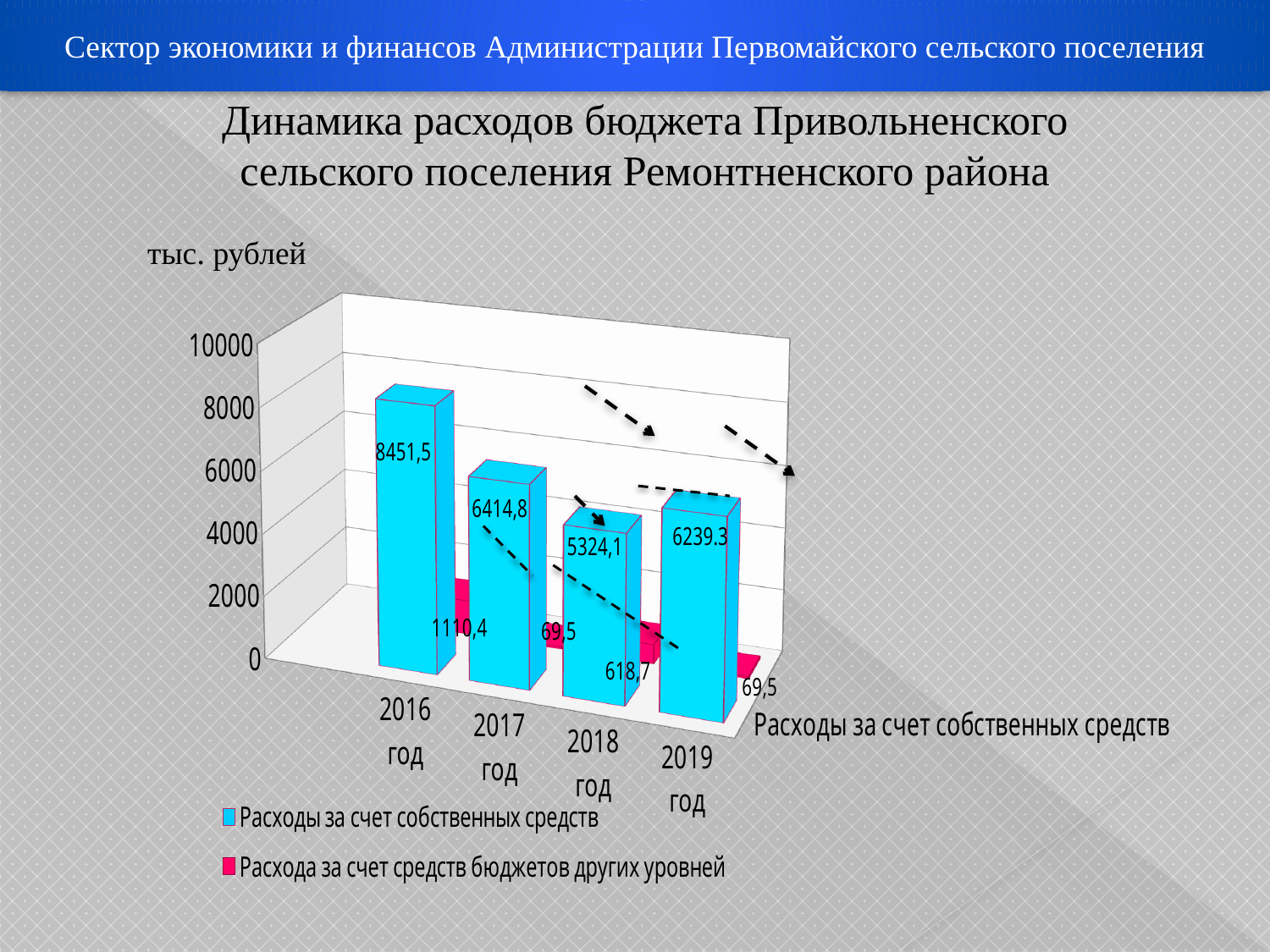
How many years (categories) are shown on the x axis? 4 What type of chart is shown on the slide? bar chart What unit is stated above the chart? тыс. рублей What is the value of 'Расходы за счет собственных средств' for 2018 год? 5324,1 In which year is 'Расходы за счет собственных средств' the lowest? 2018 год What is the value of 'Расходы за счет собственных средств' for 2016 год? 8451,5 What is the value of 'Расхода за счет средств бюджетов других уровней' for 2018 год? 618,7 In which year is 'Расходы за счет собственных средств' the highest? 2016 год What is the difference between 'Расходы за счет собственных средств' in 2016 год and 2017 год? 2036,7 Which is larger for 'Расходы за счет собственных средств': 2017 год or 2019 год? 2017 год What is the value of 'Расхода за счет средств бюджетов других уровней' for 2016 год? 1110,4 How many series does the legend list? 2